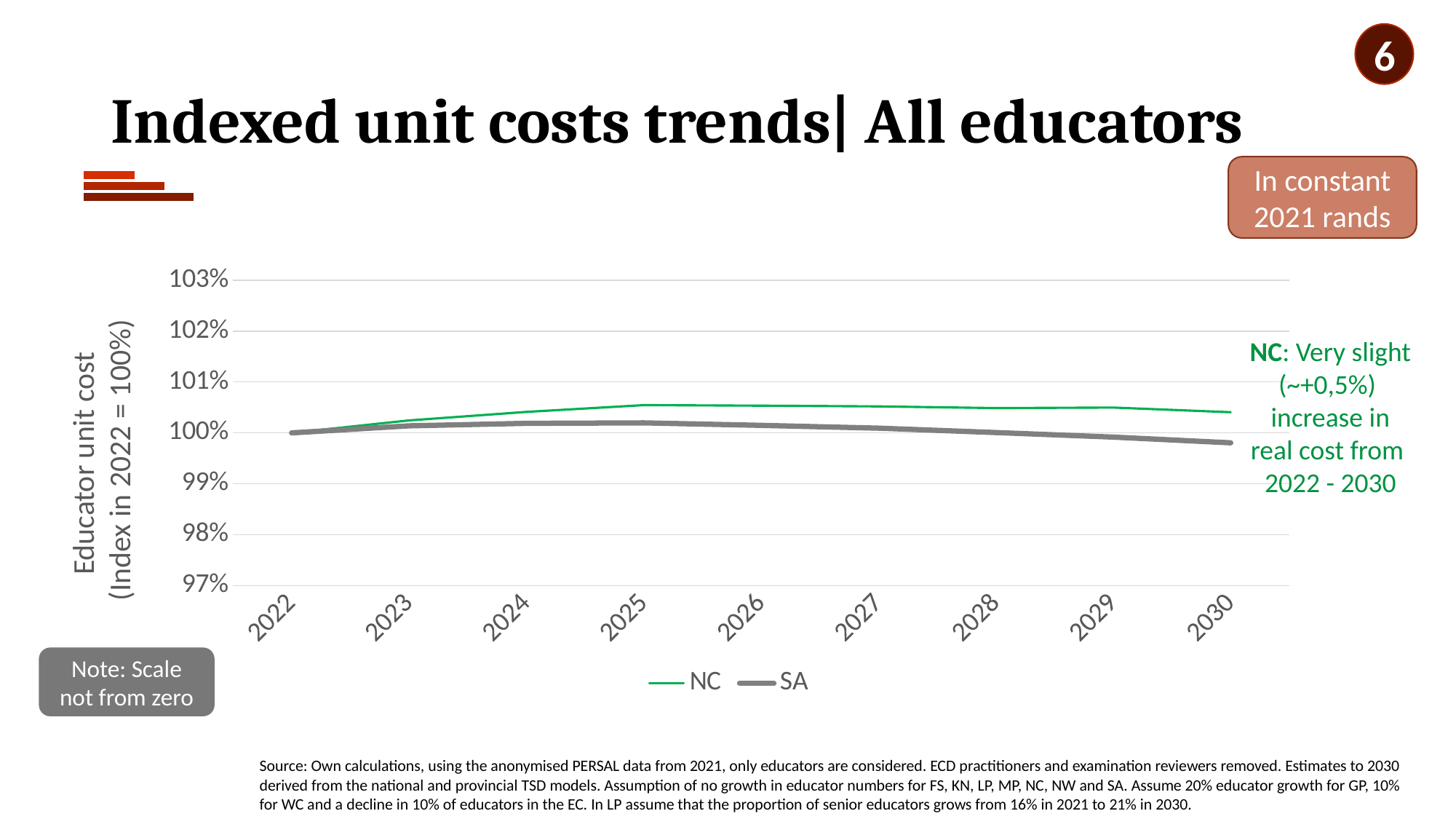
Which two series are listed in the chart legend? NC and SA Is the value for NC in 2030 greater or less than 100%? greater What kind of chart is shown on the slide? line chart What is the title of the chart on the slide? Indexed unit costs trends| All educators In 2030, which series has the higher value, NC or SA? NC Is the value for NC in 2025 greater or less than 101%? less Is the value for SA in 2030 greater or less than 100%? less How many years are plotted along the x axis? 9 Does the SA line rise or fall between 2025 and 2030? fall What is the index value of educator unit cost in 2022, the base year? 100% Does the NC line rise or fall between 2022 and 2025? rise How many series does the chart legend list? 2